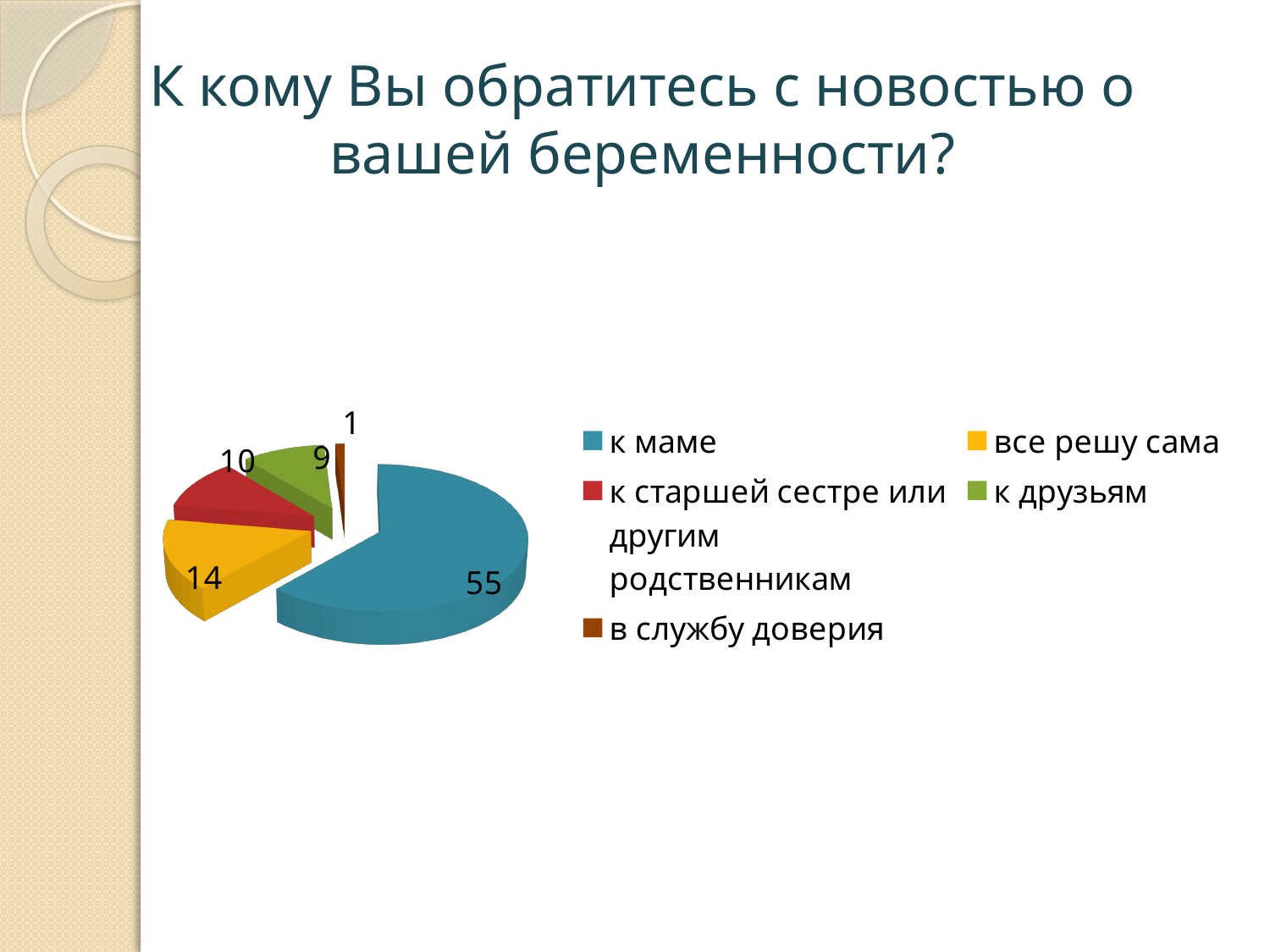
Which is larger, the value for "к старшей сестре или другим родственникам" or the value for "к друзьям"? к старшей сестре или другим родственникам How many categories does the pie chart have? 5 What is the value for "к старшей сестре или другим родственникам"? 10 What is the difference between the values for "к маме" and "все решу сама"? 41 What is the value for "все решу сама"? 14 Which category has the smallest slice of the pie? в службу доверия What is the value for "в службу доверия"? 1 What is the value for "к маме"? 55 Which category has the largest slice of the pie? к маме What is the value for "к друзьям"? 9 What colour is the slice for "все решу сама"? yellow What type of chart is shown on the slide? pie chart